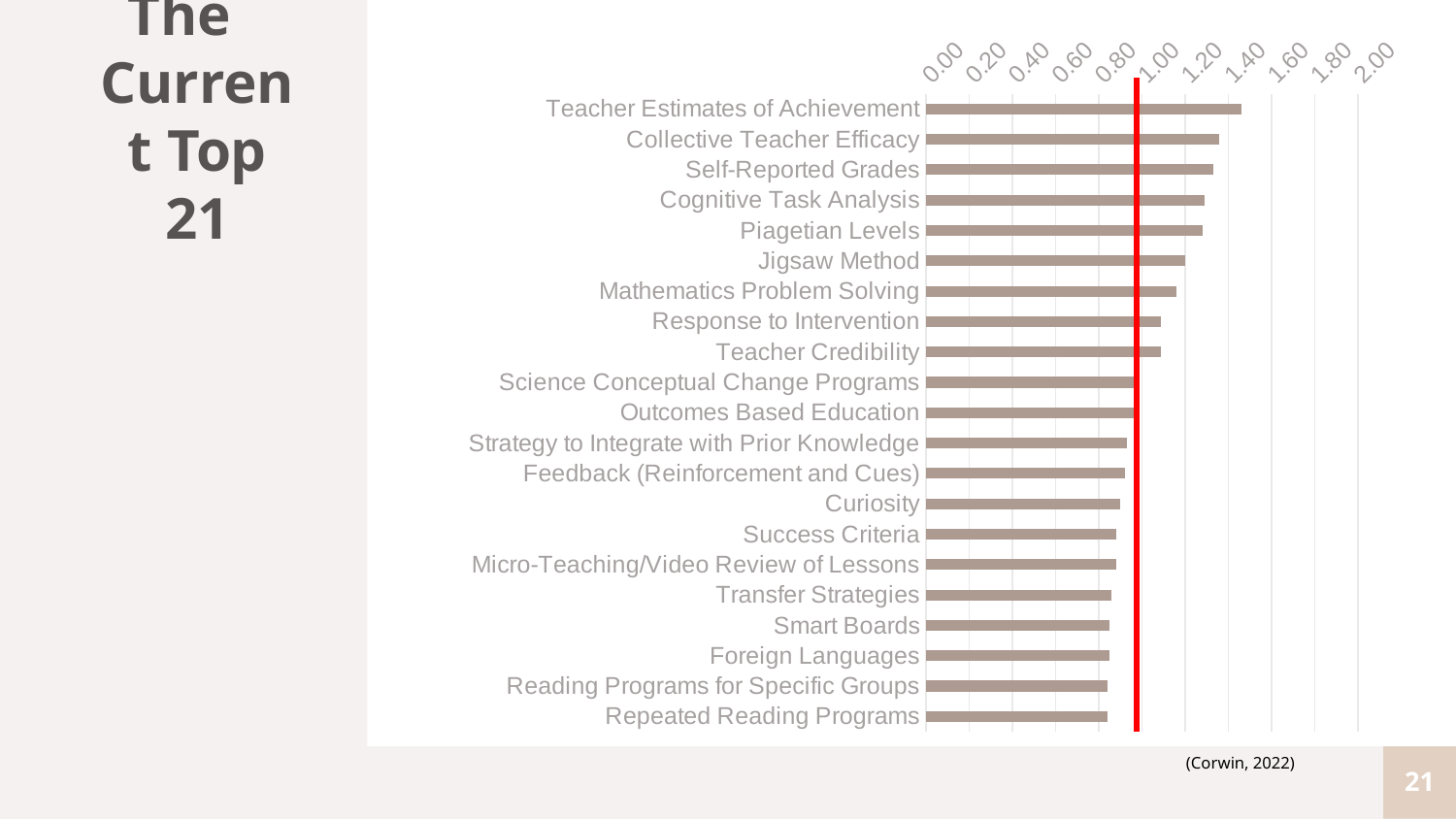
How many categories (influences) are plotted in the chart? 21 Is the value for Success Criteria greater or less than 0.80? greater What kind of chart is shown on the slide? Bar chart Is the value for Repeated Reading Programs greater or less than 1.00? less Is the value for Mathematics Problem Solving greater or less than 1.00? greater Which category has the highest value in the chart? Teacher Estimates of Achievement What source is cited below the chart? (Corwin, 2022) Which has the larger value, Jigsaw Method or Curiosity? Jigsaw Method Do the bar values increase or decrease going from the top category to the bottom category? Decrease